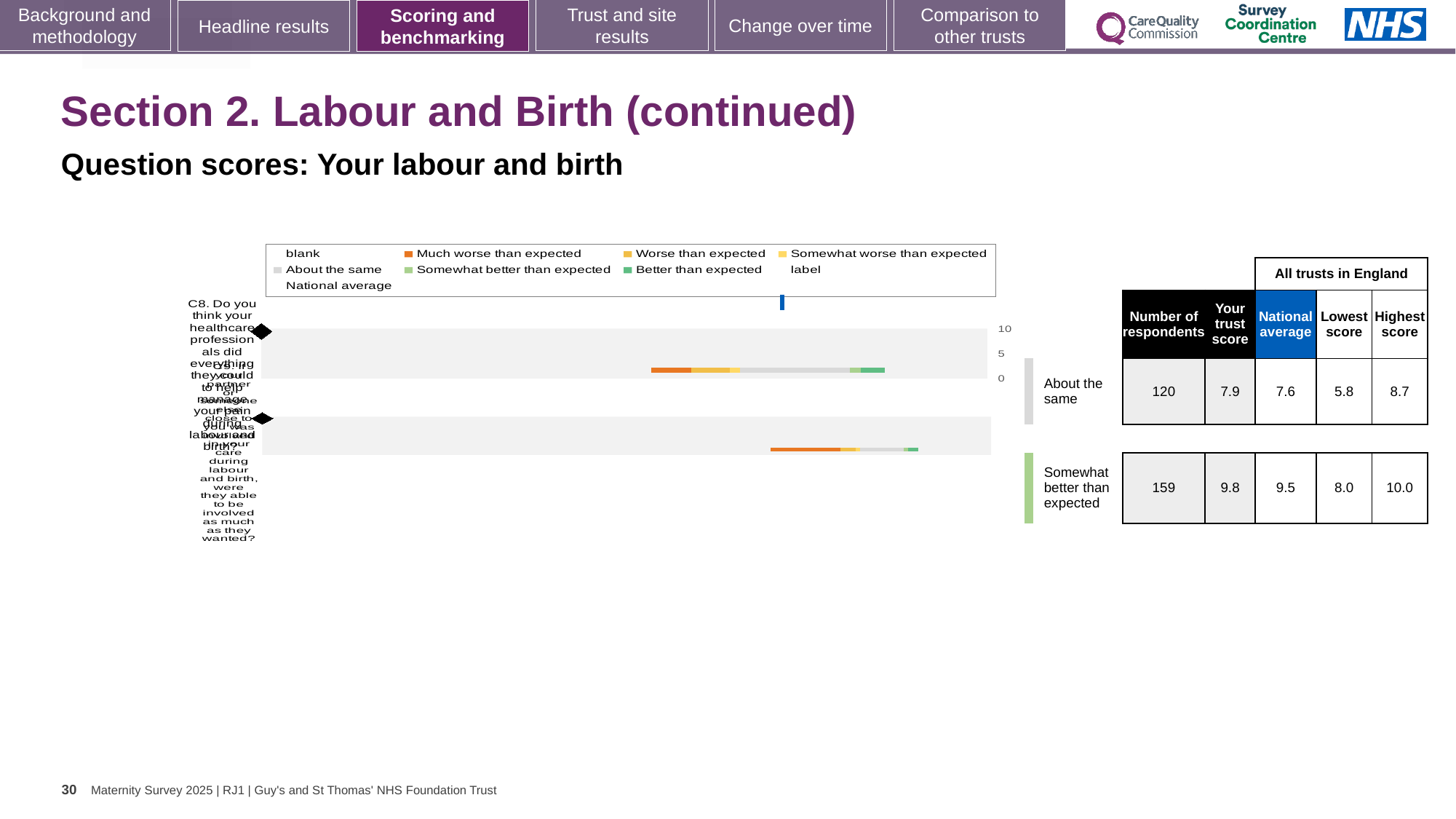
In the chart legend, which colour represents 'Much worse than expected'? orange In the table beside the chart, what is the difference between 'Your trust score' and the national average for the row rated 'About the same'? 0.3 In the table beside the chart, what is the national average for the row rated 'About the same'? 7.6 In the table beside the chart, what is the number of respondents for the row rated 'About the same'? 120 How many question rows are plotted in the bar chart? 2 In the table beside the chart, which row has the larger number of respondents, 'About the same' or 'Somewhat better than expected'? Somewhat better than expected In the table beside the chart, what is the highest score for the row rated 'Somewhat better than expected'? 10.0 What kind of chart is shown on the slide? bar chart In the table beside the chart, what is the lowest score for the row rated 'About the same'? 5.8 In the table beside the chart, what is 'Your trust score' for the row rated 'Somewhat better than expected'? 9.8 In the chart legend, which colour represents 'Better than expected'? green In the table beside the chart, what is the difference between the highest score and the lowest score for the row rated 'Somewhat better than expected'? 2.0